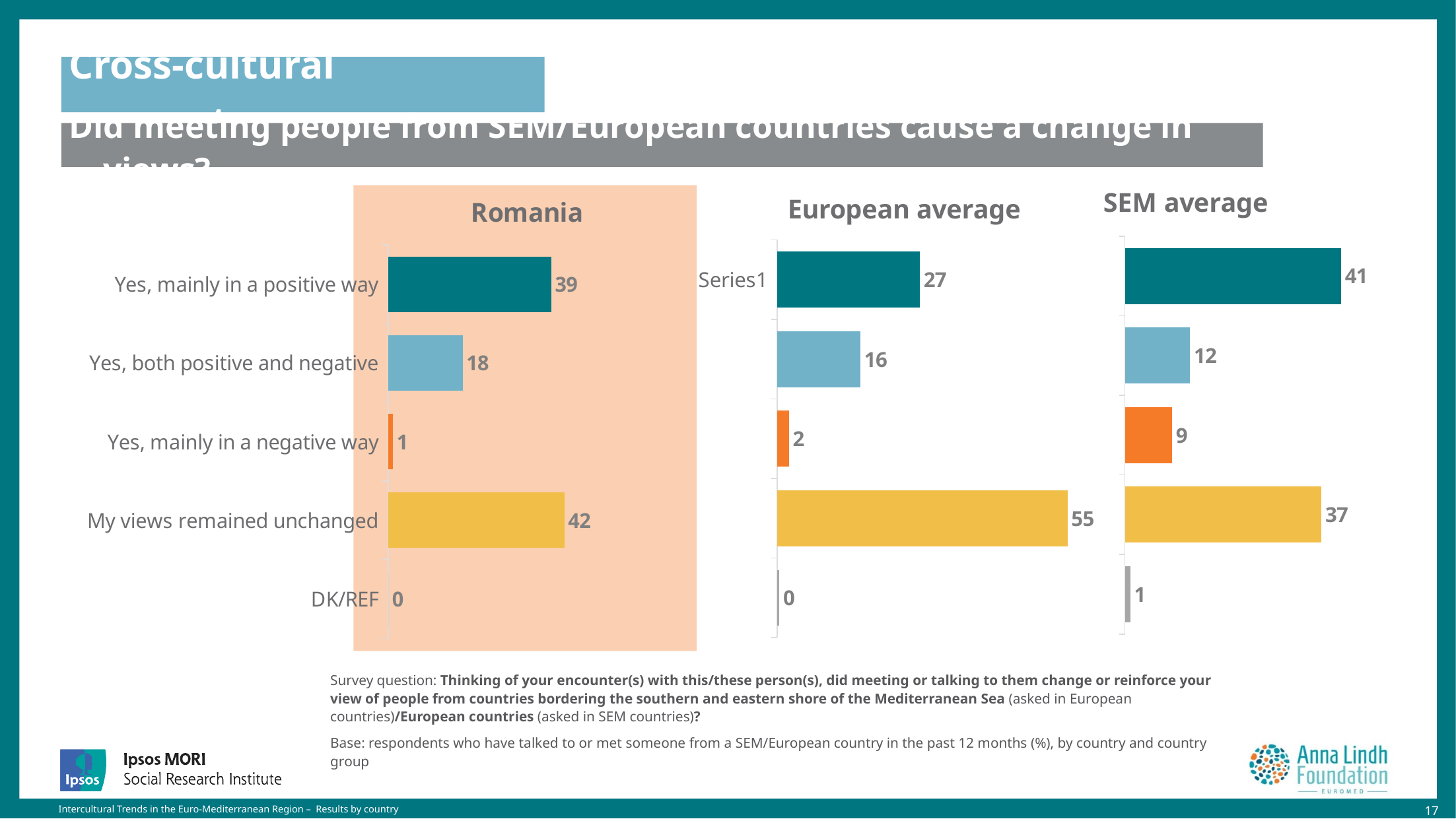
In the European average chart, which category has the lowest value? DK/REF Which is larger: 'Yes, both positive and negative' in the Romania chart or in the SEM average chart? Romania How many categories does the Romania chart show? 5 In the Romania chart, what is the value for 'Yes, mainly in a positive way'? 39 In the Romania chart, what is the value for 'DK/REF'? 0 In the SEM average chart, which category has the highest value? Yes, mainly in a positive way What type of chart is used for the European average? Bar chart In the SEM average chart, what is the difference between 'Yes, mainly in a positive way' and 'My views remained unchanged'? 4 In the European average chart, what is the value for 'My views remained unchanged'? 55 In the Romania chart, what is the difference between 'My views remained unchanged' and 'Yes, mainly in a positive way'? 3 In the Romania chart, which category has the highest value? My views remained unchanged In the SEM average chart, what is the value for 'Yes, mainly in a negative way'? 9